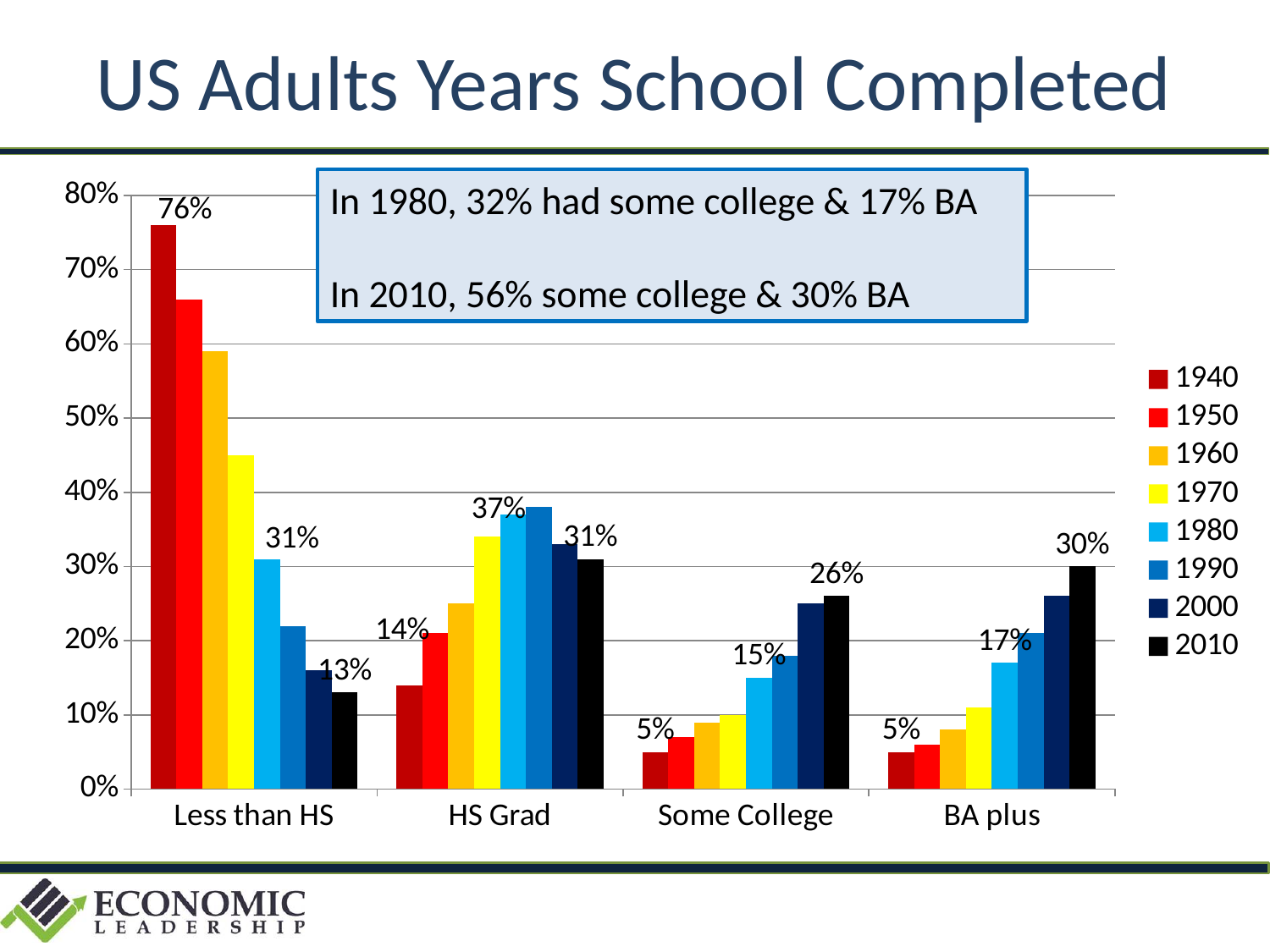
Do the values in the Less than HS category rise or fall from 1940 to 2010? Fall Which category has the highest value for the 1940 series? Less than HS What is the value for the 1980 series in the Some College category? 15% What percentage of US adults had less than a high school education in 1940? 76% How many education categories are shown on the x axis? 4 What kind of chart is shown on the slide? Bar chart Is the value for the 1960 series in the Less than HS category greater or less than 50%? greater What is the difference between the 1940 and 2010 values in the Less than HS category? 63% How many series does the legend list? 8 What is the value for the 2010 series in the Less than HS category? 13% What is the value for the 2010 series in the BA plus category? 30% Which is larger: the 2010 value for Some College or the 2010 value for BA plus? BA plus